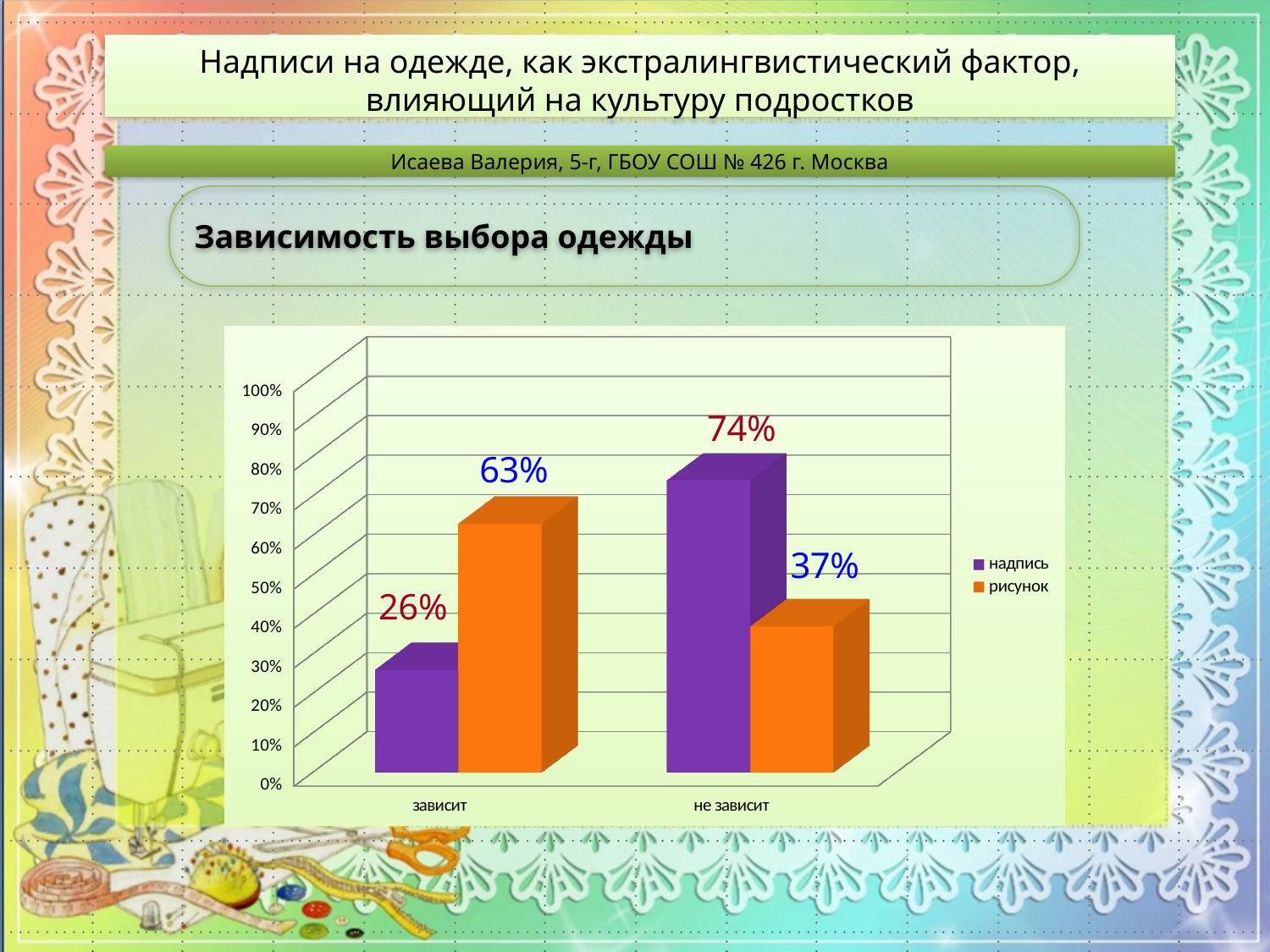
How many series does the legend list? 2 Which is larger in the "зависит" category: "надпись" or "рисунок"? рисунок What colour are the bars for the "рисунок" series? orange Which category has the highest value for the "надпись" series? не зависит What is the value for "надпись" in the "не зависит" category? 74% What is the value for "рисунок" in the "зависит" category? 63% How many categories are shown on the x axis? 2 What is the value for "надпись" in the "зависит" category? 26% What is the difference between the "надпись" values for "не зависит" and "зависит"? 48% What is the value for "рисунок" in the "не зависит" category? 37% Which category has the lowest value for the "рисунок" series? не зависит What kind of chart is shown on the slide? bar chart